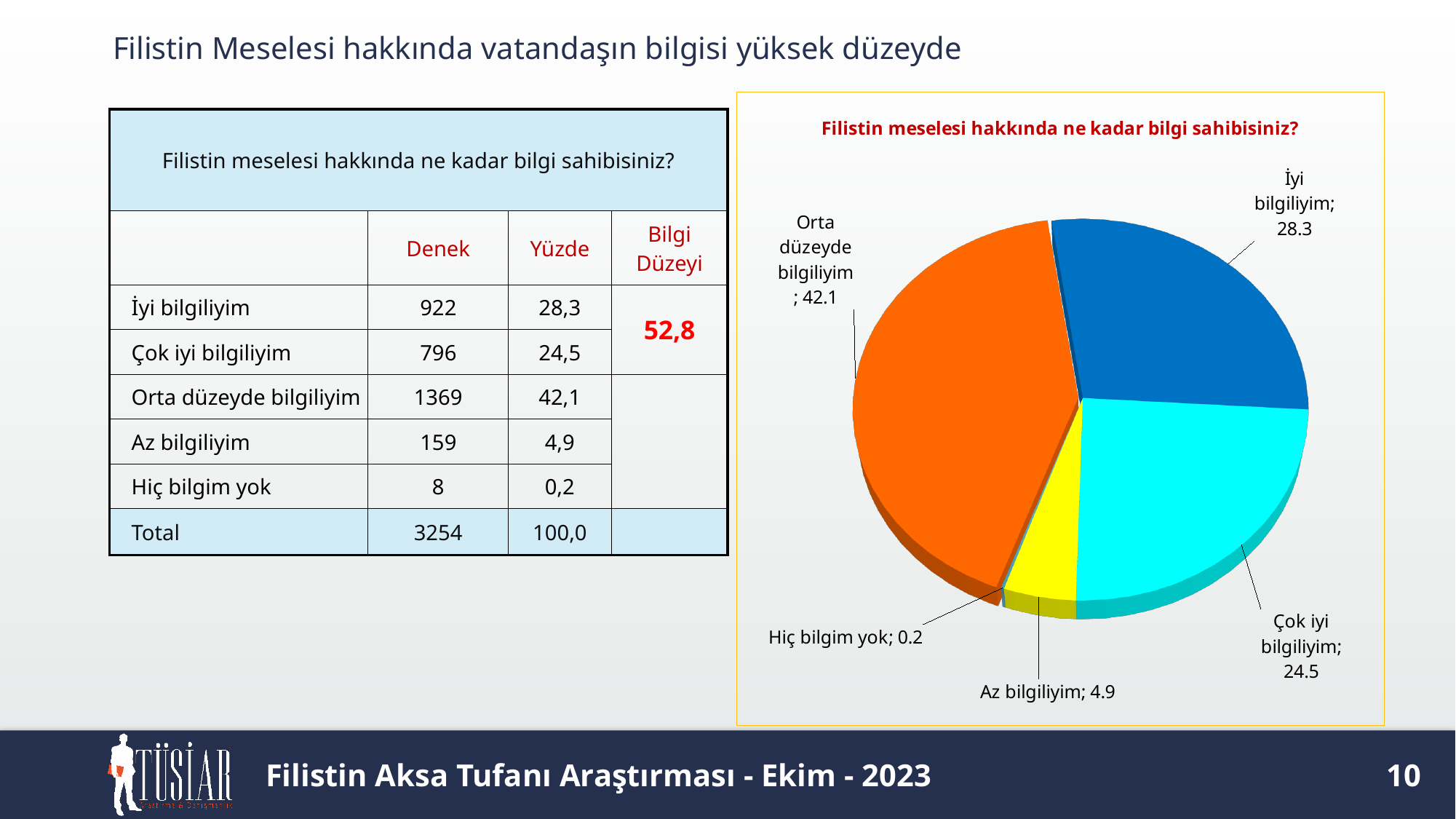
In the pie chart, what is the difference between the values for "İyi bilgiliyim" and "Çok iyi bilgiliyim"? 3.8 In the pie chart, what is the value for "Az bilgiliyim"? 4.9 Which category has the smallest slice in the pie chart? Hiç bilgim yok In the pie chart, what is the value for "İyi bilgiliyim"? 28.3 What is the title of the pie chart? Filistin meselesi hakkında ne kadar bilgi sahibisiniz? In the pie chart, what is the value for "Çok iyi bilgiliyim"? 24.5 In the pie chart, what is the value for "Orta düzeyde bilgiliyim"? 42.1 What type of chart is shown on the slide? pie chart In the pie chart, which is larger: "Orta düzeyde bilgiliyim" or "İyi bilgiliyim"? Orta düzeyde bilgiliyim How many slices does the pie chart have? 5 Which category has the largest slice in the pie chart? Orta düzeyde bilgiliyim In the pie chart, what is the value for "Hiç bilgim yok"? 0.2